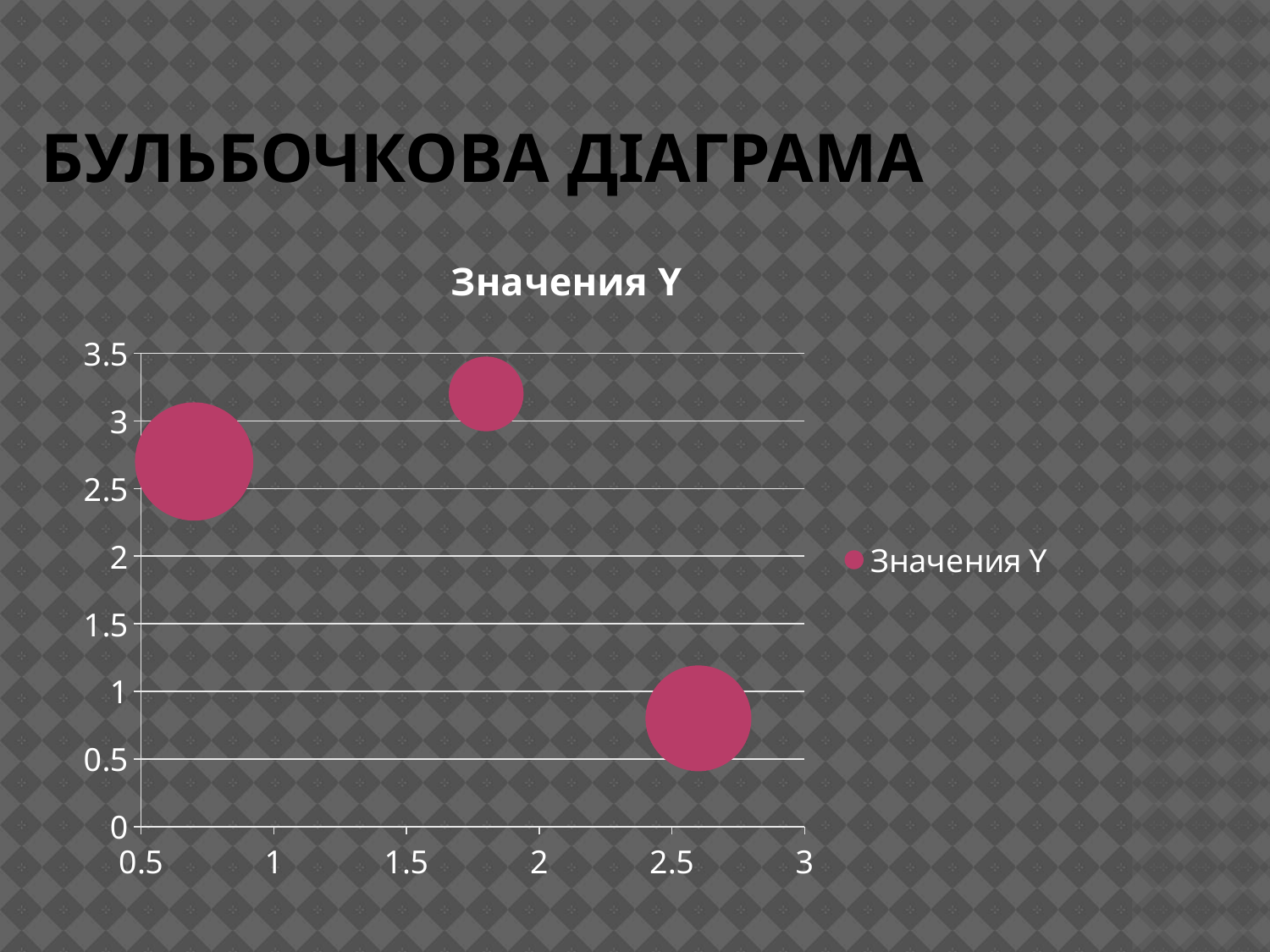
What kind of chart is shown on the slide? bubble chart What is the title of the chart? Значения Y Is the y value of the bubble located near x = 2.6 greater or less than 1? less How many series does the legend list? 1 How many bubbles are plotted on the chart? 3 Is the y value of the bubble located near x = 0.7 greater or less than 2.5? greater Which bubble has the highest y value: the one near x = 0.7, near x = 1.8, or near x = 2.6? the one near x = 1.8 Which bubble has the larger y value: the one near x = 0.7 or the one near x = 2.6? the one near x = 0.7 What is the name of the series shown in the legend? Значения Y Does the y value rise or fall from the bubble near x = 1.8 to the bubble near x = 2.6? fall Which bubble has the lowest y value: the one near x = 0.7, near x = 1.8, or near x = 2.6? the one near x = 2.6 Is the y value of the bubble located near x = 1.8 greater or less than 3? greater